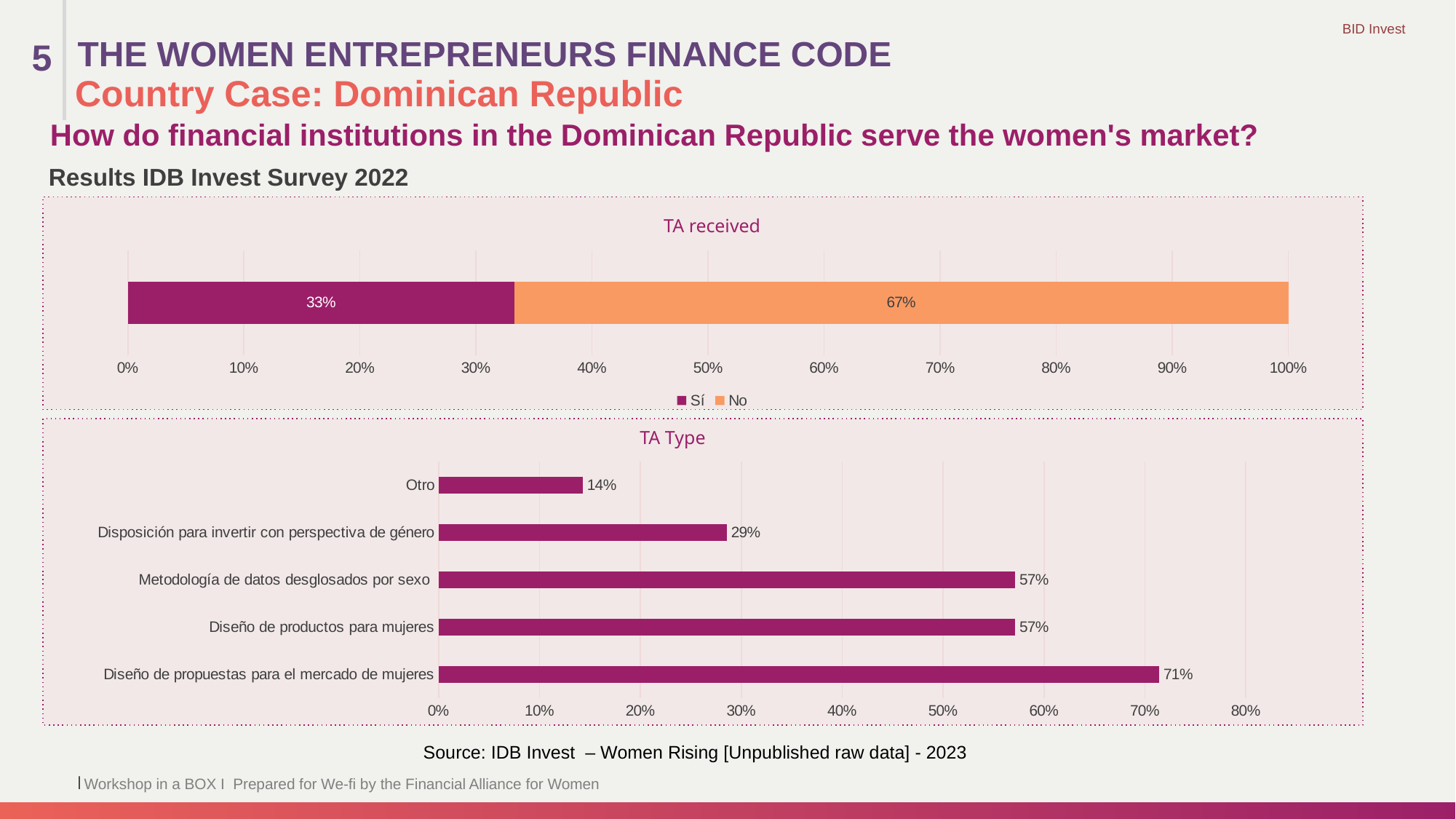
In the 'TA received' chart, which is larger, 'Sí' or 'No'? No In the 'TA Type' chart, what is the value for 'Otro'? 14% In the 'TA received' chart, how many series does the legend list? 2 In the 'TA received' chart, what percentage is shown for 'Sí'? 33% What kind of chart is the 'TA Type' chart? Bar chart In the 'TA Type' chart, which category has the lowest value? Otro In the 'TA Type' chart, what is the difference between 'Diseño de propuestas para el mercado de mujeres' and 'Otro'? 57% In the 'TA received' chart, what percentage is shown for 'No'? 67% In the 'TA received' chart, what is the total of the stacked bar? 100% In the 'TA Type' chart, what is the value for 'Disposición para invertir con perspectiva de género'? 29% In the 'TA Type' chart, which category has the highest value? Diseño de propuestas para el mercado de mujeres In the 'TA Type' chart, how many categories are shown? 5